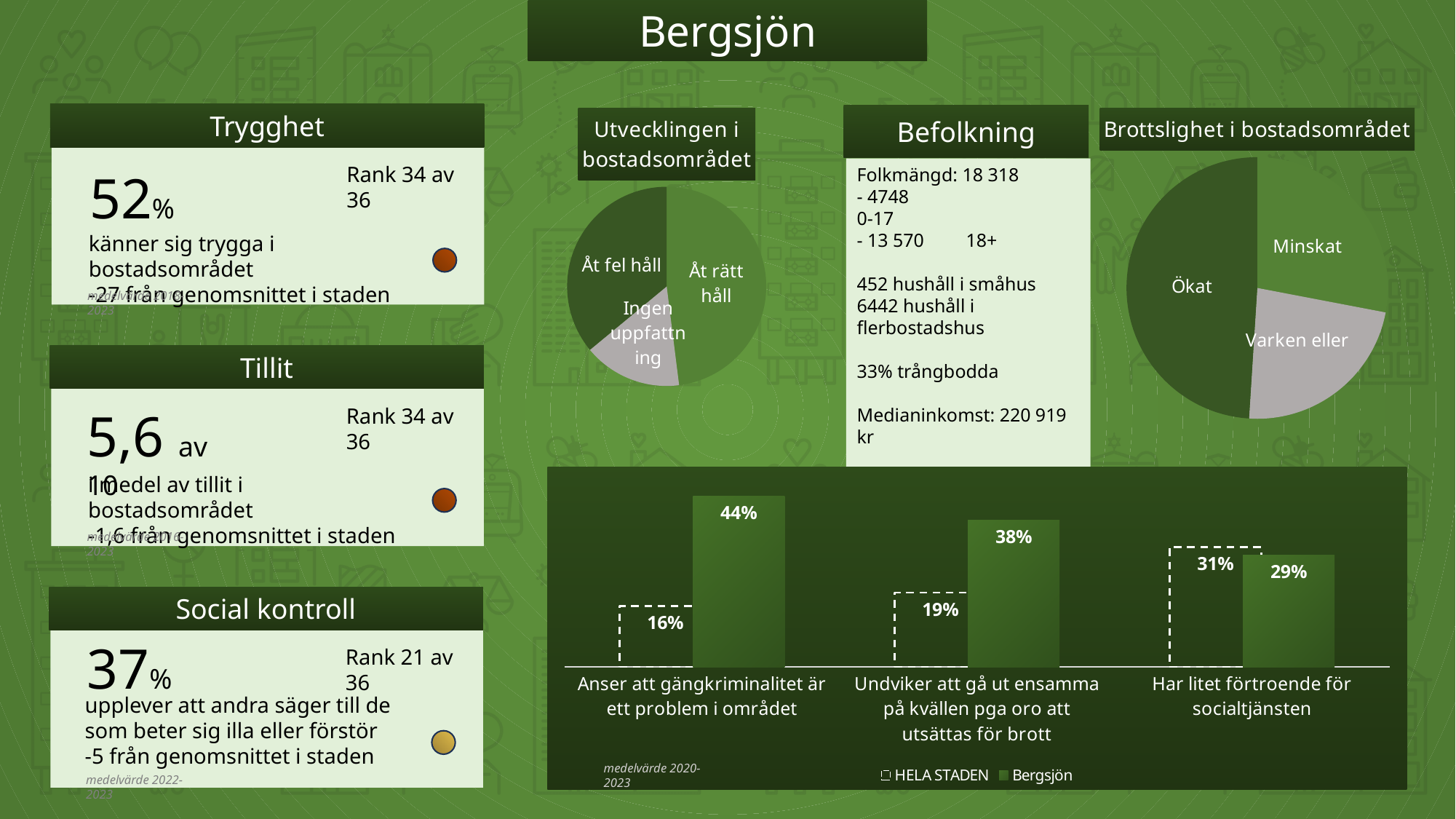
In the bar chart at the bottom of the slide, which category has the lowest HELA STADEN value? Anser att gängkriminalitet är ett problem i området In the bar chart at the bottom of the slide, what is the value for Bergsjön for 'Har litet förtroende för socialtjänsten'? 29% How many categories are shown in the bar chart at the bottom of the slide? 3 In the pie chart 'Utvecklingen i bostadsområdet', which slice is the smallest? Ingen uppfattning In the bar chart at the bottom of the slide, what is the value for Bergsjön for 'Anser att gängkriminalitet är ett problem i området'? 44% In the bar chart at the bottom of the slide, what is the difference between the Bergsjön and HELA STADEN values for 'Anser att gängkriminalitet är ett problem i området'? 28% What kind of chart is 'Brottslighet i bostadsområdet'? Pie chart In the bar chart at the bottom of the slide, what is the value for HELA STADEN for 'Undviker att gå ut ensamma på kvällen pga oro att utsättas för brott'? 19% In the bar chart at the bottom of the slide, for 'Har litet förtroende för socialtjänsten', which is larger: HELA STADEN or Bergsjön? HELA STADEN In the bar chart at the bottom of the slide, which category has the highest Bergsjön value? Anser att gängkriminalitet är ett problem i området How many series does the legend of the bar chart at the bottom of the slide list? 2 In the pie chart 'Brottslighet i bostadsområdet', which slice is the largest? Ökat